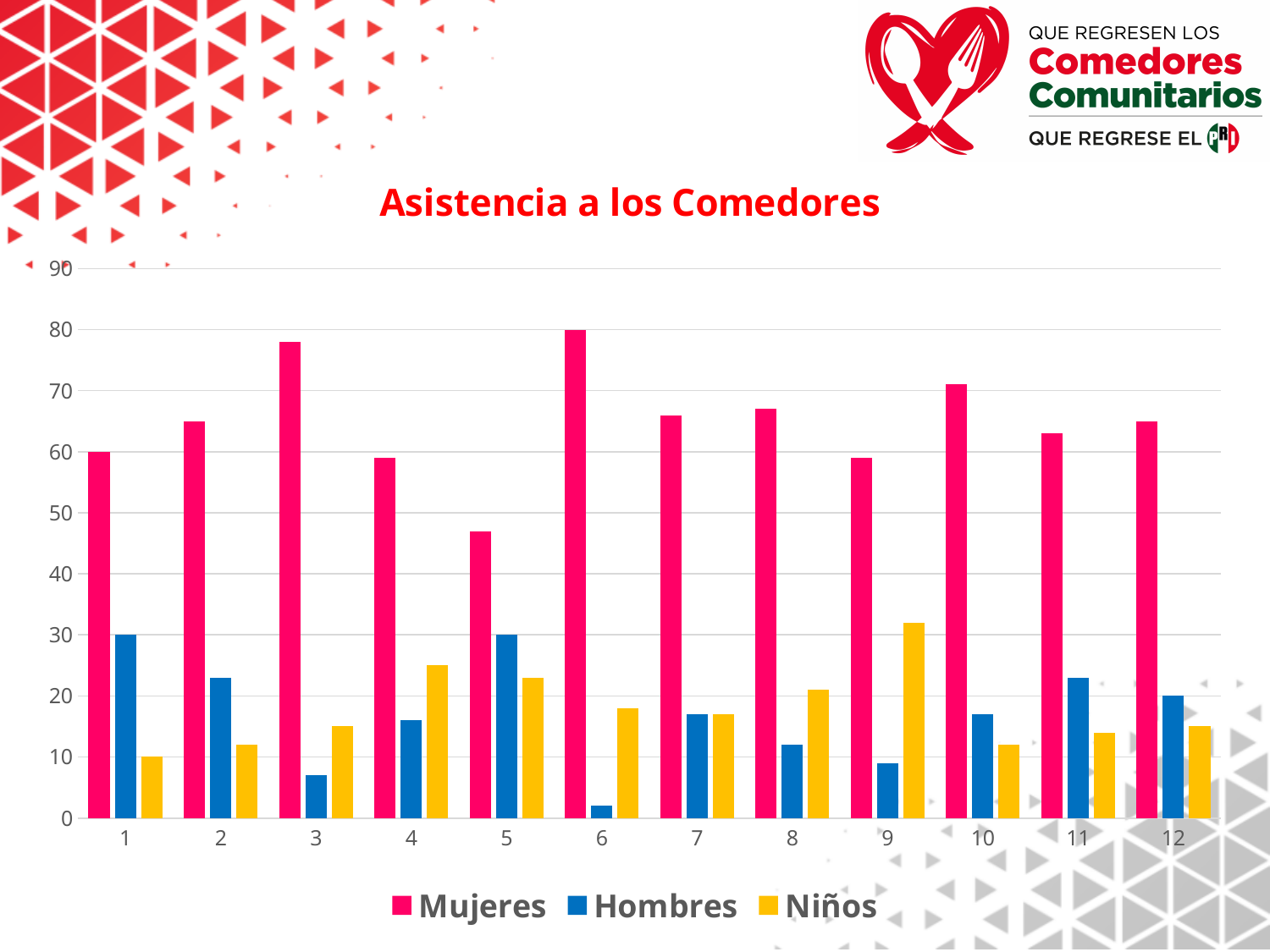
Which is larger at category 4, the Hombres value or the Niños value? Niños How many categories are shown on the x axis? 12 What is the value for Mujeres at category 6? 80 What type of chart is shown on the slide? Bar chart How many series does the legend list? 3 In which category is the Niños value highest? 9 In which category is the Mujeres value lowest? 5 What is the value for Hombres at category 1? 30 What is the value for Niños at category 1? 10 In which category is the Hombres value lowest? 6 Is the value for Mujeres at category 3 greater or less than 70? greater What is the title of the chart? Asistencia a los Comedores